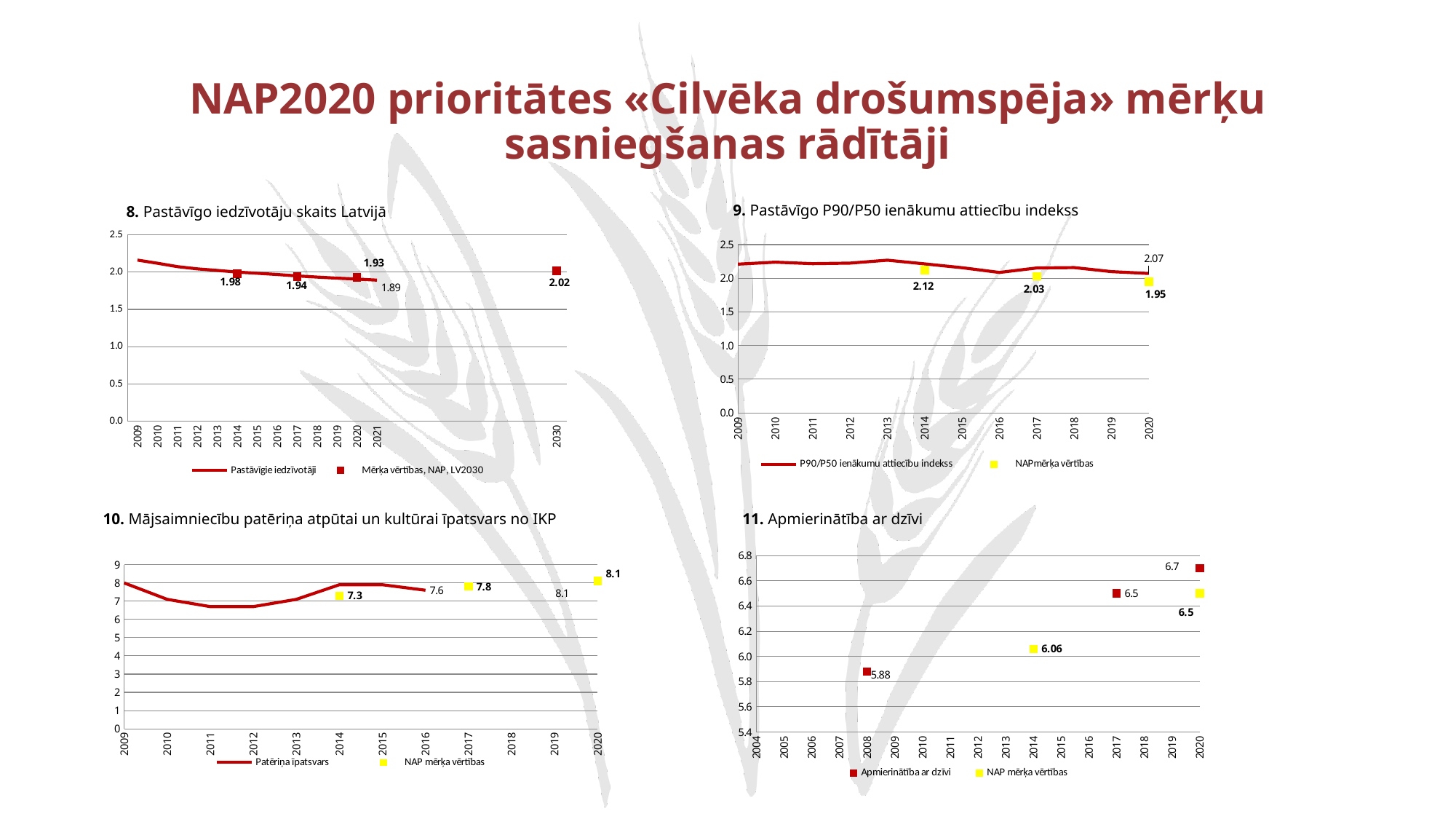
In the chart "10. Mājsaimniecību patēriņa atpūtai un kultūrai īpatsvars no IKP", which NAP target value is larger, the one for 2014 or the one for 2020? 2020 How many series does the legend of the chart "9. Pastāvīgo P90/P50 ienākumu attiecību indekss" list? 2 In the chart "10. Mājsaimniecību patēriņa atpūtai un kultūrai īpatsvars no IKP", do the NAP target values rise or fall from 2014 to 2020? Rise In the chart "8. Pastāvīgo iedzīvotāju skaits Latvijā", what is the target value (Mērķa vērtības) shown for 2030? 2.02 In the chart "9. Pastāvīgo P90/P50 ienākumu attiecību indekss", what is the NAP target value (NAP mērķa vērtības) for 2020? 1.95 In the chart "10. Mājsaimniecību patēriņa atpūtai un kultūrai īpatsvars no IKP", what is the NAP target value for 2017? 7.8 In the chart "9. Pastāvīgo P90/P50 ienākumu attiecību indekss", what is the difference between the NAP target values for 2014 and 2017? 0.09 In the chart "11. Apmierinātība ar dzīvi", what is the Apmierinātība ar dzīvi value for 2008? 5.88 What kind of chart is "8. Pastāvīgo iedzīvotāju skaits Latvijā"? Line chart In the chart "8. Pastāvīgo iedzīvotāju skaits Latvijā", what is the target value shown for 2014? 1.98 In the chart "11. Apmierinātība ar dzīvi", which year has the highest labelled Apmierinātība ar dzīvi value? 2020